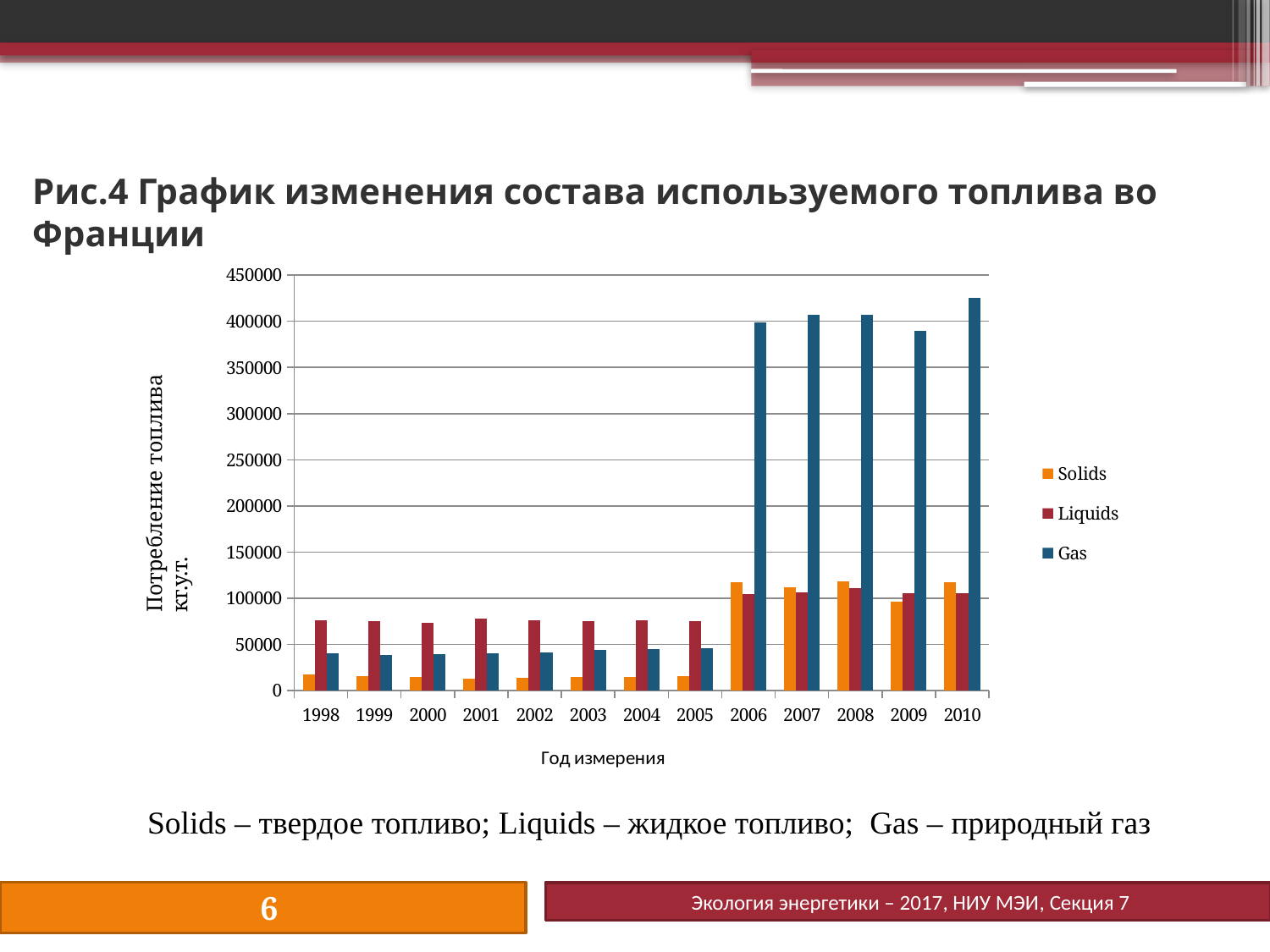
In which year is the Gas value highest? 2010 Is the Liquids value for 1998 greater or less than 50000? greater What is the title of the x axis? Год измерения Is the Gas value for 2010 greater or less than 400000? greater How many series does the legend list? 3 Is the Gas value for 1998 greater or less than 50000? less Which is larger in 1998, the Liquids value or the Gas value? Liquids What kind of chart is shown on the slide? bar chart Which is larger in 2006, the Gas value or the Liquids value? Gas How many years are shown on the x axis? 13